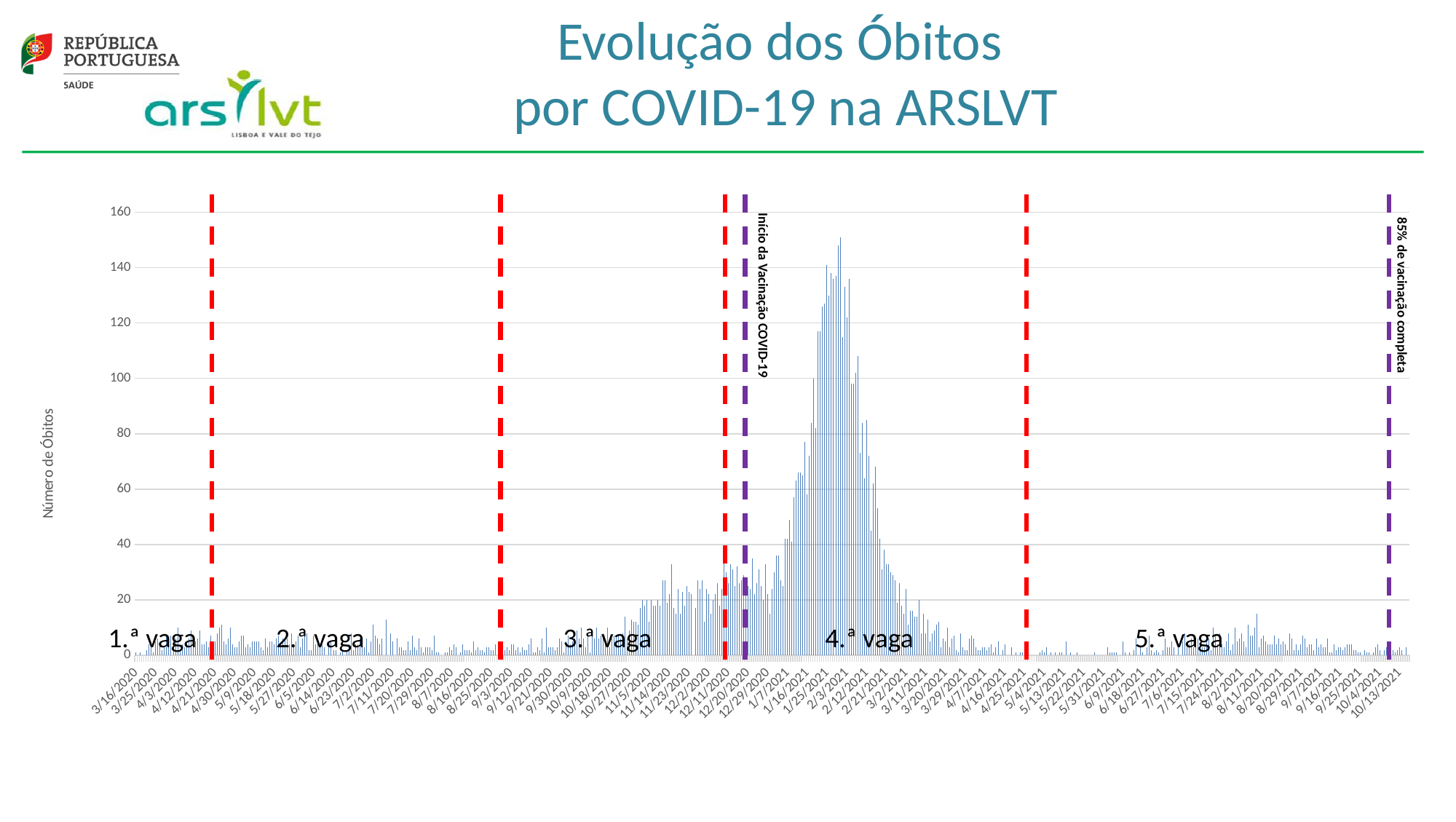
Which wave has the highest peak in daily deaths? 4.ª vaga Is the highest daily value in the 5.ª vaga greater or less than 20? less What is the label of the vertical axis? Número de Óbitos What is the title of the chart on the slide? Evolução dos Óbitos por COVID-19 na ARSLVT Is the highest daily value in the 1.ª vaga greater or less than 20? less What is the first date shown on the horizontal axis? 3/16/2020 What is the highest tick value shown on the vertical axis? 160 What kind of chart is shown on the slide? bar chart Is the highest daily value in the 3.ª vaga greater or less than 40? less Which wave reached a higher peak of daily deaths, the 3.ª vaga or the 4.ª vaga? 4.ª vaga How many waves (vagas) are labelled on the chart? 5